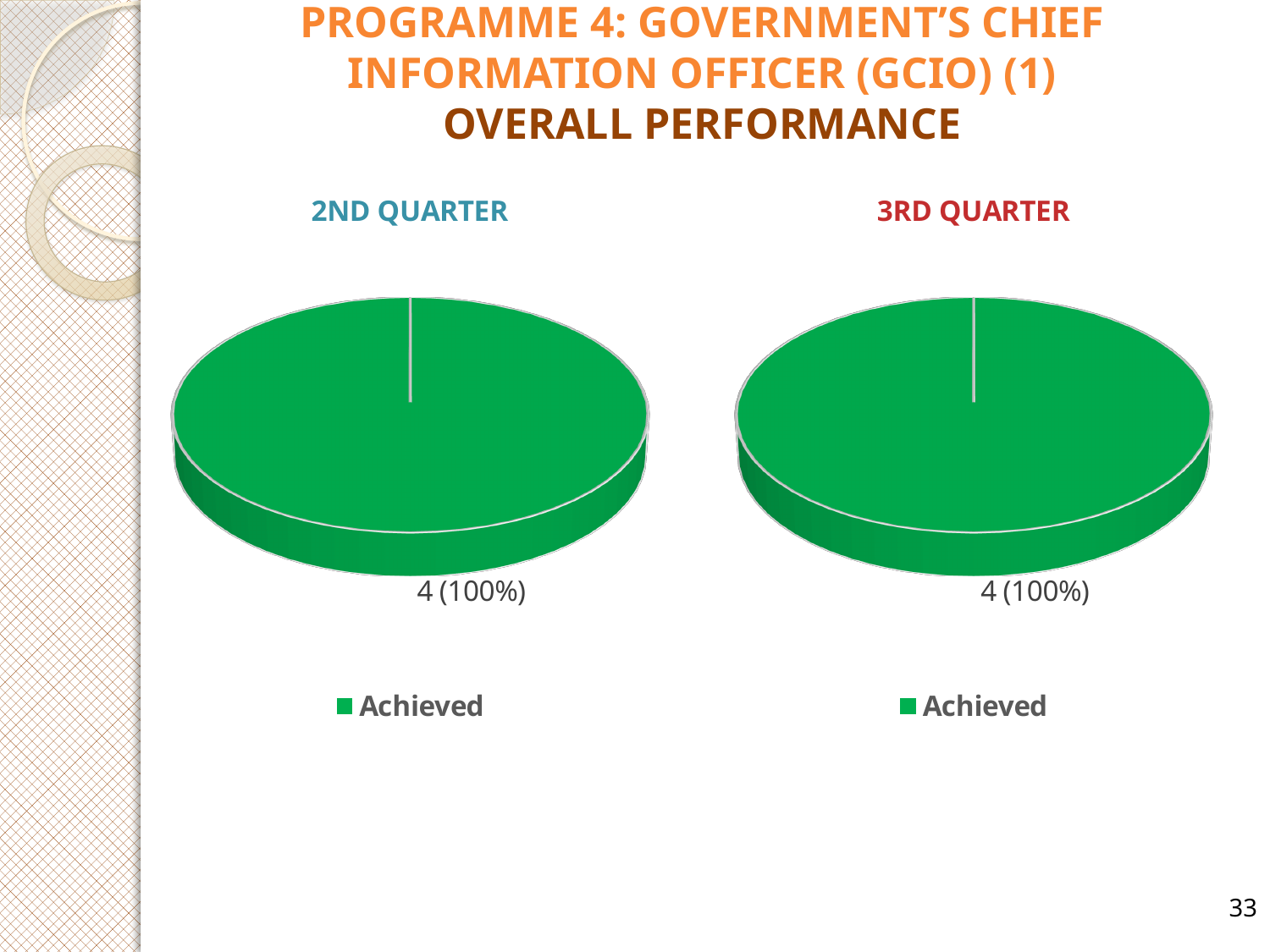
What kind of chart is the 2ND QUARTER chart? Pie chart What kind of chart is the 3RD QUARTER chart? Pie chart How many slices does the 3RD QUARTER pie chart have? 1 In the 3RD QUARTER chart, what is the data label shown for the Achieved slice? 4 (100%) What is the legend entry shown for the 3RD QUARTER chart? Achieved How many slices does the 2ND QUARTER pie chart have? 1 In the 2ND QUARTER chart, what share of the pie does the Achieved slice take? 100% In the 3RD QUARTER chart, what share of the pie does the Achieved slice take? 100% What colour is the Achieved slice in the 2ND QUARTER chart? Green What is the difference between the Achieved count in the 3RD QUARTER chart and the Achieved count in the 2ND QUARTER chart? 0 How many entries does the legend of the 2ND QUARTER chart list? 1 In the 2ND QUARTER chart, what is the data label shown for the Achieved slice? 4 (100%)